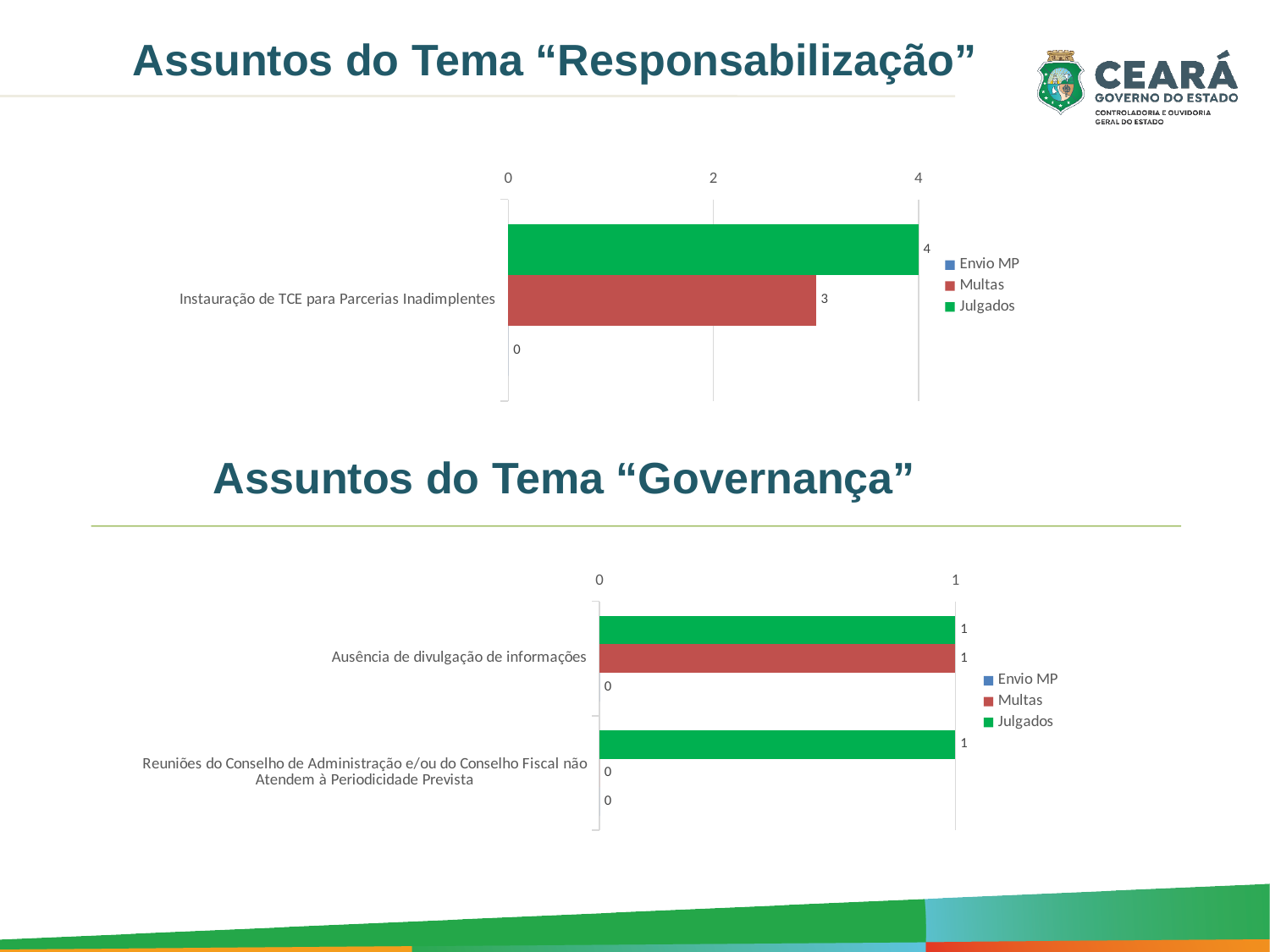
In the 'Assuntos do Tema "Governança"' chart, what is the value of Multas for Ausência de divulgação de informações? 1 In the 'Assuntos do Tema "Governança"' chart, which colour represents the Multas series? Red In the 'Assuntos do Tema "Responsabilização"' chart, how many series does the legend list? 3 In the 'Assuntos do Tema "Responsabilização"' chart, what is the value of Envio MP? 0 In the 'Assuntos do Tema "Responsabilização"' chart, what is the value of Multas for Instauração de TCE para Parcerias Inadimplentes? 3 In the 'Assuntos do Tema "Governança"' chart, how many categories are shown? 2 What kind of chart is the 'Assuntos do Tema "Governança"' chart? Bar chart In the 'Assuntos do Tema "Governança"' chart, which is larger for Reuniões do Conselho de Administração e/ou do Conselho Fiscal não Atendem à Periodicidade Prevista: Julgados or Envio MP? Julgados In the 'Assuntos do Tema "Responsabilização"' chart, what is the value of Julgados for Instauração de TCE para Parcerias Inadimplentes? 4 In the 'Assuntos do Tema "Governança"' chart, what is the value of Multas for Reuniões do Conselho de Administração e/ou do Conselho Fiscal não Atendem à Periodicidade Prevista? 0 In the 'Assuntos do Tema "Responsabilização"' chart, which series has the highest value? Julgados In the 'Assuntos do Tema "Responsabilização"' chart, what is the difference between Julgados and Multas? 1